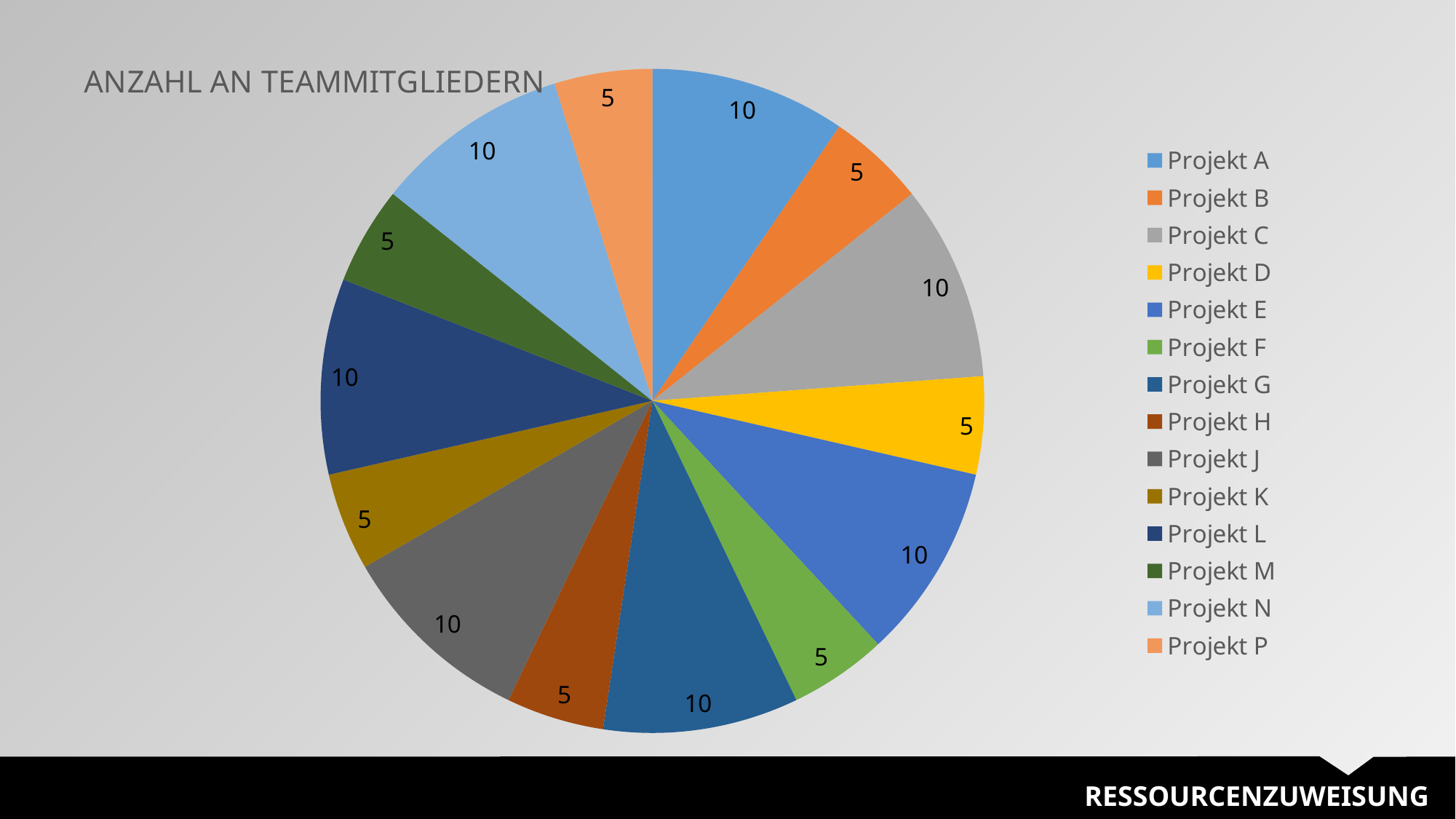
What is the difference between the value for Projekt E and the value for Projekt F? 5 What is the value for Projekt B? 5 What is the value for Projekt D? 5 How many slices does the pie chart have? 14 What is the value for Projekt A? 10 What is the value for Projekt P? 5 Which is larger, the value for Projekt C or the value for Projekt H? Projekt C How many entries does the legend list? 14 What is the value for Projekt L? 10 What is the total of all slices in the pie chart? 105 What kind of chart is shown on the slide? pie chart What is the title of the chart? ANZAHL AN TEAMMITGLIEDERN